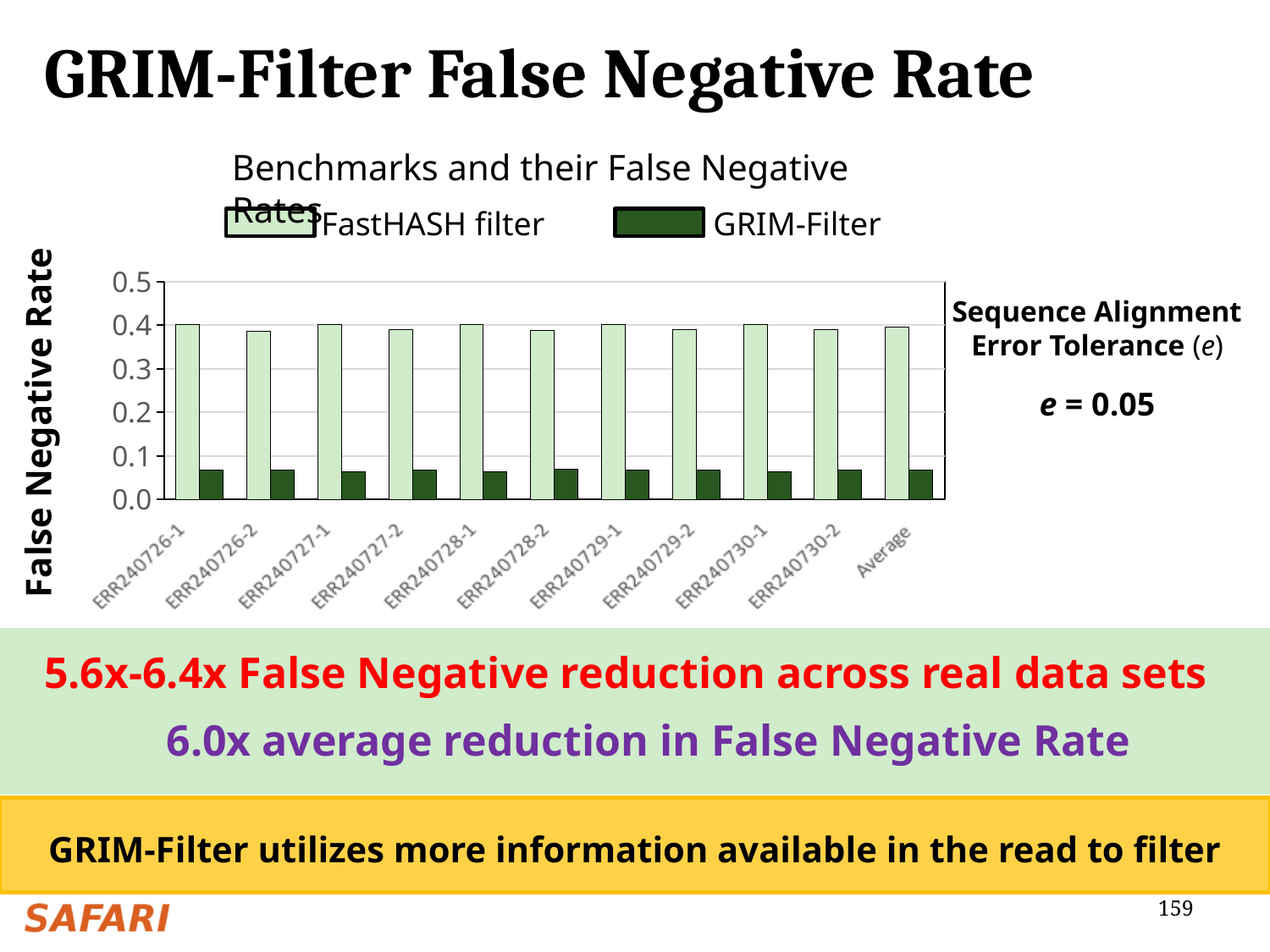
How many categories are shown along the x axis of the chart? 11 Is the FastHASH filter value for ERR240727-1 greater or less than 0.3? greater Which series has the larger value for Average, FastHASH filter or GRIM-Filter? FastHASH filter Is the GRIM-Filter value for Average greater or less than 0.1? less Is the FastHASH filter value for ERR240730-2 greater or less than 0.5? less What is the title of the chart? Benchmarks and their False Negative Rates Which series has the larger value for ERR240726-1, FastHASH filter or GRIM-Filter? FastHASH filter What is the label on the chart's vertical axis? False Negative Rate What kind of chart is shown on the slide? bar chart How many series does the chart's legend list? 2